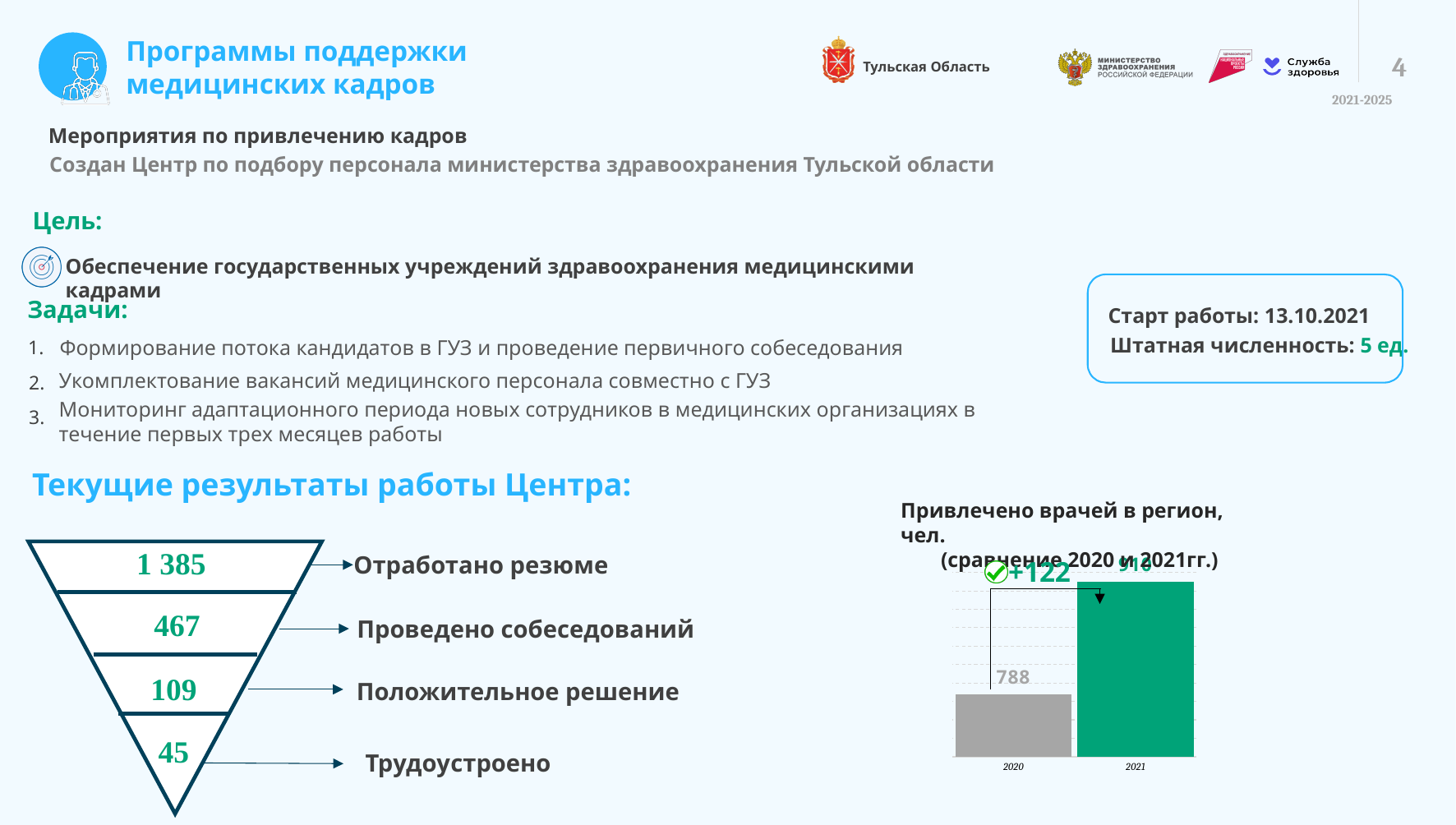
In the bar chart 'Привлечено врачей в регион, чел.', which year has the lower value? 2020 In the bar chart 'Привлечено врачей в регион, чел.', by how much did the value increase from 2020 to 2021, as annotated on the chart? +122 In the funnel diagram under 'Текущие результаты работы Центра', what is the value for 'Отработано резюме'? 1 385 In the bar chart 'Привлечено врачей в регион, чел.', do the values rise or fall from 2020 to 2021? rise What kind of chart is shown under the title 'Привлечено врачей в регион, чел.'? bar chart How many stages does the funnel diagram under 'Текущие результаты работы Центра' have? 4 In the funnel diagram under 'Текущие результаты работы Центра', what is the value for 'Трудоустроено'? 45 In the bar chart 'Привлечено врачей в регион, чел.', what is the value for 2020? 788 How many bars are plotted in the bar chart 'Привлечено врачей в регион, чел.'? 2 In the bar chart 'Привлечено врачей в регион, чел.', is the value for 2021 larger or smaller than the value for 2020? larger In the bar chart 'Привлечено врачей в регион, чел.', what colour is the bar for 2021? green In the bar chart 'Привлечено врачей в регион, чел.', which year has the higher value? 2021